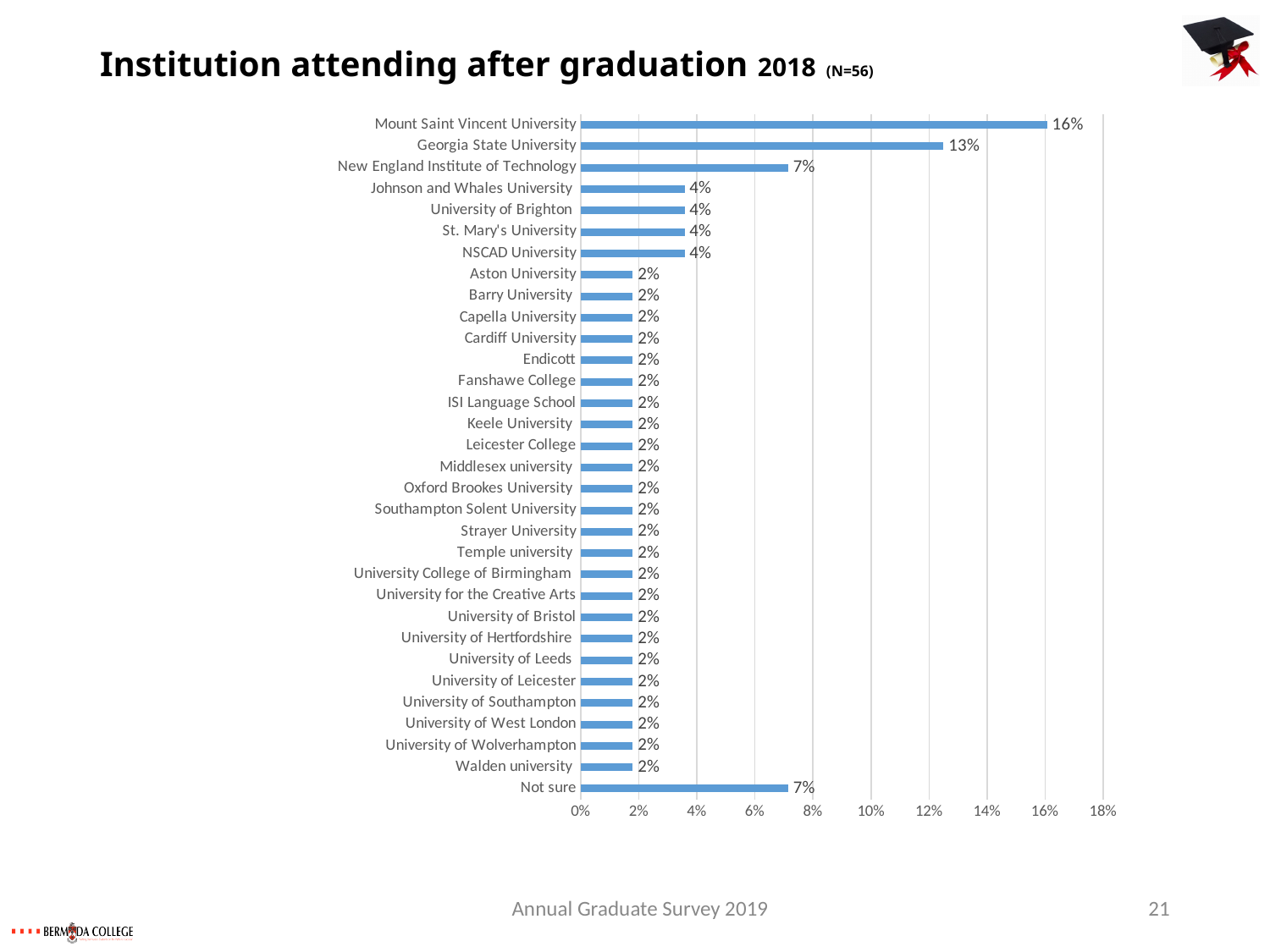
What is the value for NSCAD University? 4% What is the difference between Georgia State University and New England Institute of Technology? 6% What is the difference in percentage points between Mount Saint Vincent University and Georgia State University? 3% What is the sample size (N) stated in the chart title? 56 How many institutions/categories are listed on the chart? 32 What percentage of respondents answered 'Not sure'? 7% What is the value shown for Georgia State University? 13% What type of chart is shown on the slide? Bar chart Which is larger, the value for Johnson and Whales University or the value for Aston University? Johnson and Whales University What percentage of graduates are attending Mount Saint Vincent University? 16% What percentage is shown for New England Institute of Technology? 7% Which institution has the highest percentage of graduates attending? Mount Saint Vincent University